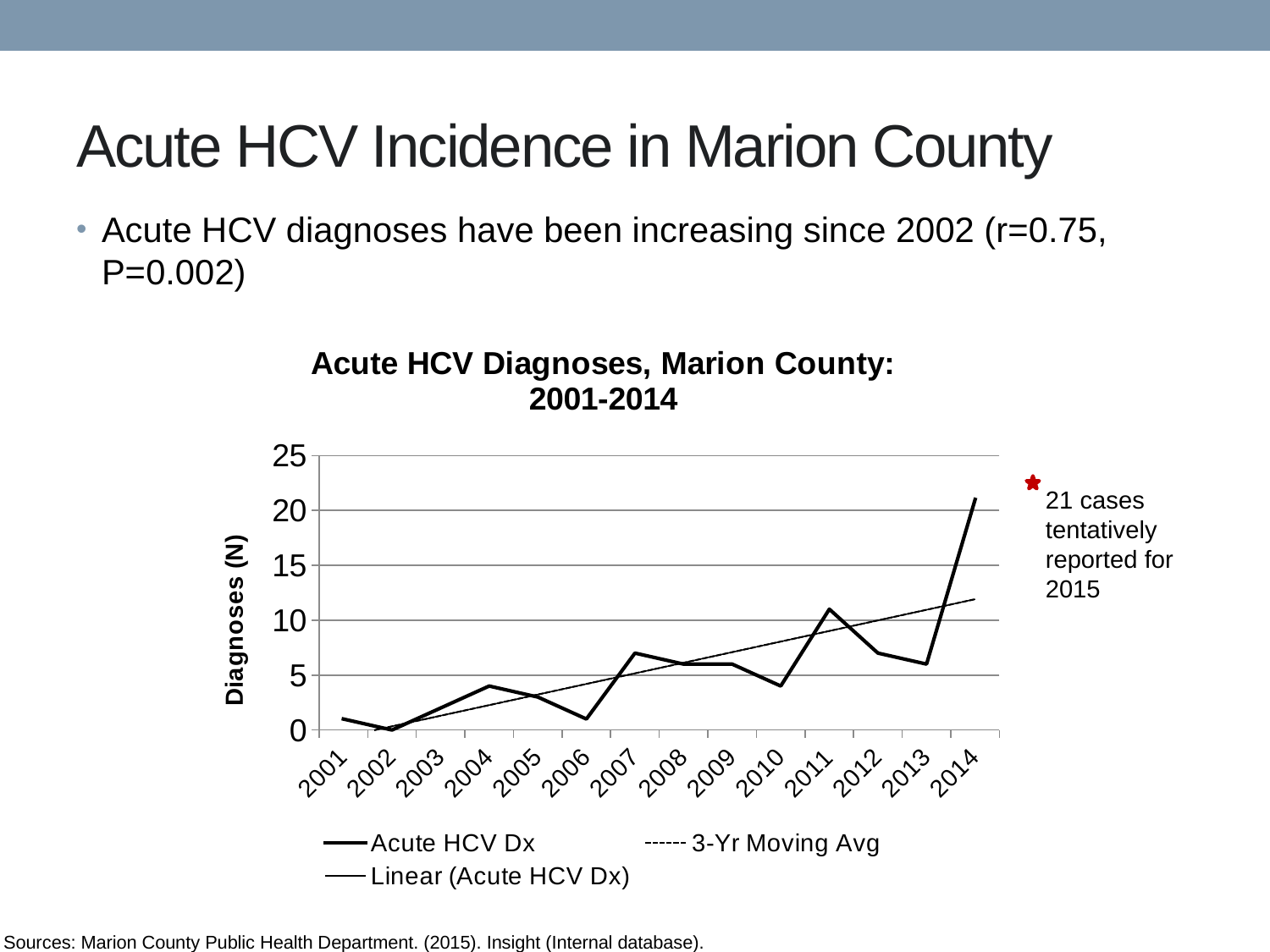
How many years are plotted along the x axis of the chart? 14 What is the label on the y axis of the chart? Diagnoses (N) Is the value for Acute HCV Dx in 2011 greater or less than 5? greater Is the value for Acute HCV Dx in 2014 greater or less than 15? greater Overall, do acute HCV diagnoses rise or fall from 2001 to 2014? rise What kind of chart is shown on the slide? line chart Is the value for Acute HCV Dx in 2006 greater or less than 5? less How many series does the chart legend list? 3 Which year has the lowest number of acute HCV diagnoses? 2002 Which year has the highest number of acute HCV diagnoses? 2014 Which year has more acute HCV diagnoses, 2010 or 2011? 2011 What is the title of the chart? Acute HCV Diagnoses, Marion County: 2001-2014